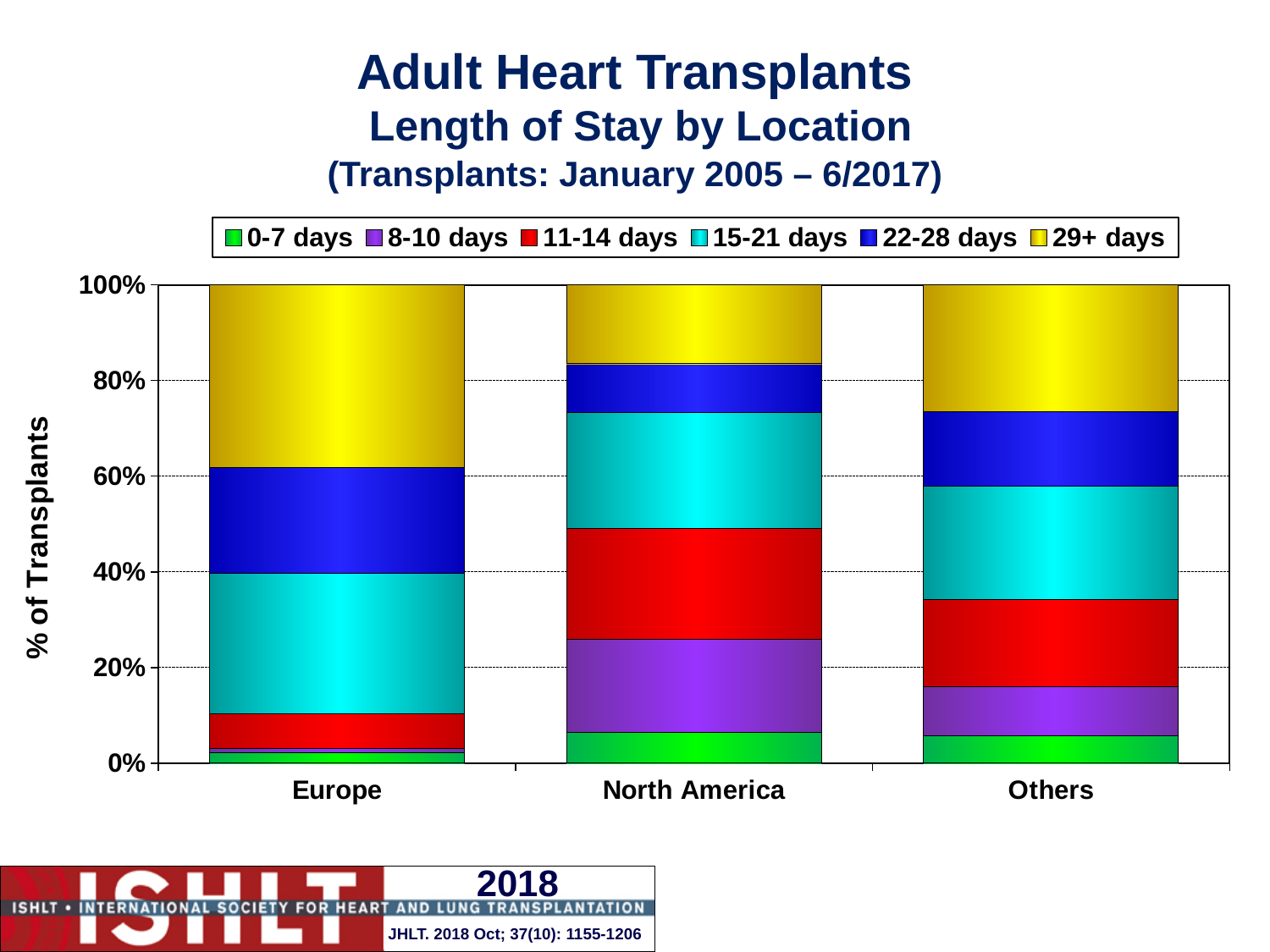
Is the value for 29+ days in Europe greater or less than 20%? greater How many locations (categories) are shown on the x axis? 3 What kind of chart is shown on the slide? stacked bar chart Which location has the largest share of transplants with a 29+ days length of stay? Europe Is the value for 0-7 days in Europe greater or less than 20%? less Is the value for 29+ days in Others greater or less than 20%? greater What is the total of the stacked bar for North America? 100% Which is larger: the 22-28 days share in Europe or the 22-28 days share in North America? Europe What is the label of the y axis? % of Transplants How many series does the legend list? 6 Which location has the smallest share of transplants with a 0-7 days length of stay? Europe Which is larger: the 8-10 days share in North America or the 8-10 days share in Europe? North America